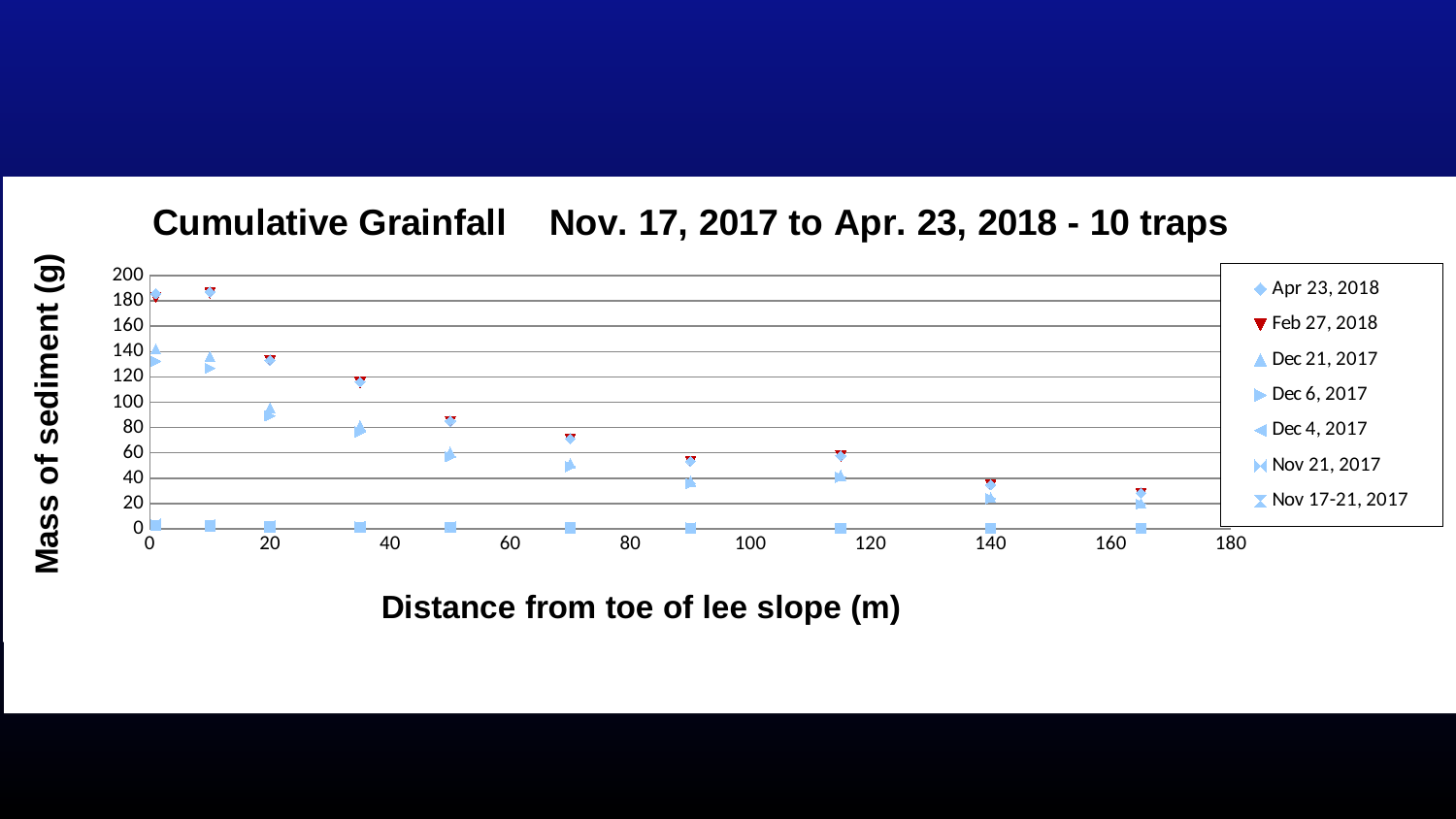
What is the label of the y axis? Mass of sediment (g) Is the Nov 17-21, 2017 value at the trap near 90 m greater or less than 20? less Is the Apr 23, 2018 value at the trap near 165 m greater or less than 40? less Is the Apr 23, 2018 value at the trap nearest 0 m greater or less than 160? greater How many traps (distance positions) are plotted along the x axis? 10 How many series does the legend list? 7 Do the Apr 23, 2018 values rise or fall as distance from the toe of the lee slope increases? fall What is the title of the chart? Cumulative Grainfall Nov. 17, 2017 to Apr. 23, 2018 - 10 traps What kind of chart is shown on the slide? scatter chart For the Apr 23, 2018 series, is the value at the trap near 20 m or the trap near 35 m larger? 20 m For the Apr 23, 2018 series, which trap distance has the lowest mass of sediment? 165 m